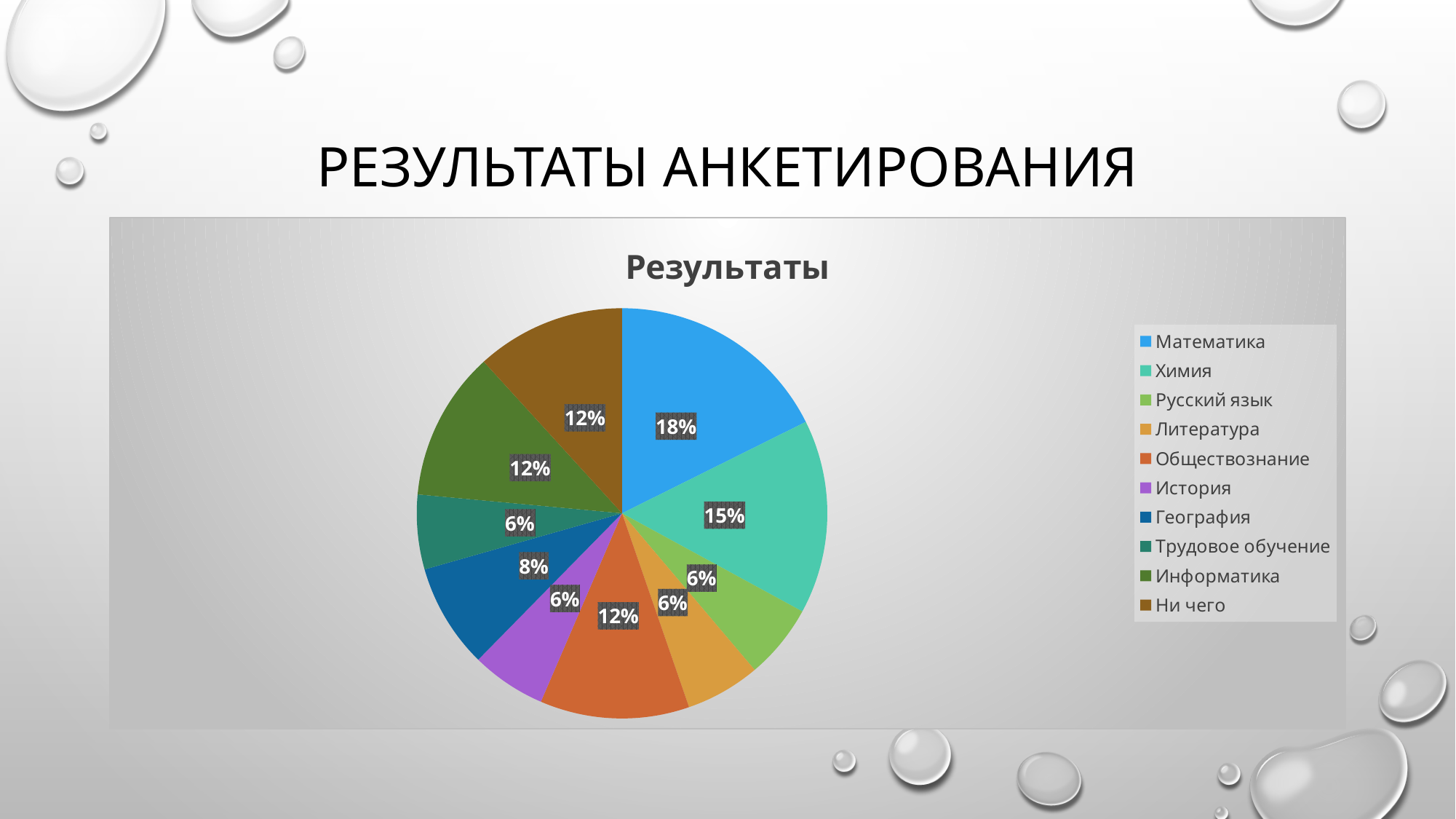
How many categories does the pie chart have? 10 Which is larger, the share for География or the share for История? География What is the difference between the shares of Математика and Химия? 3% What is the value shown for Информатика? 12% What is the value shown for Ни чего? 12% What is the value shown for География? 8% What is the title of the chart? Результаты What is the value shown for Химия? 15% What type of chart is shown on the slide? pie chart How many entries are listed in the legend? 10 Which category has the largest share of the pie? Математика What percentage of the pie does Математика account for? 18%